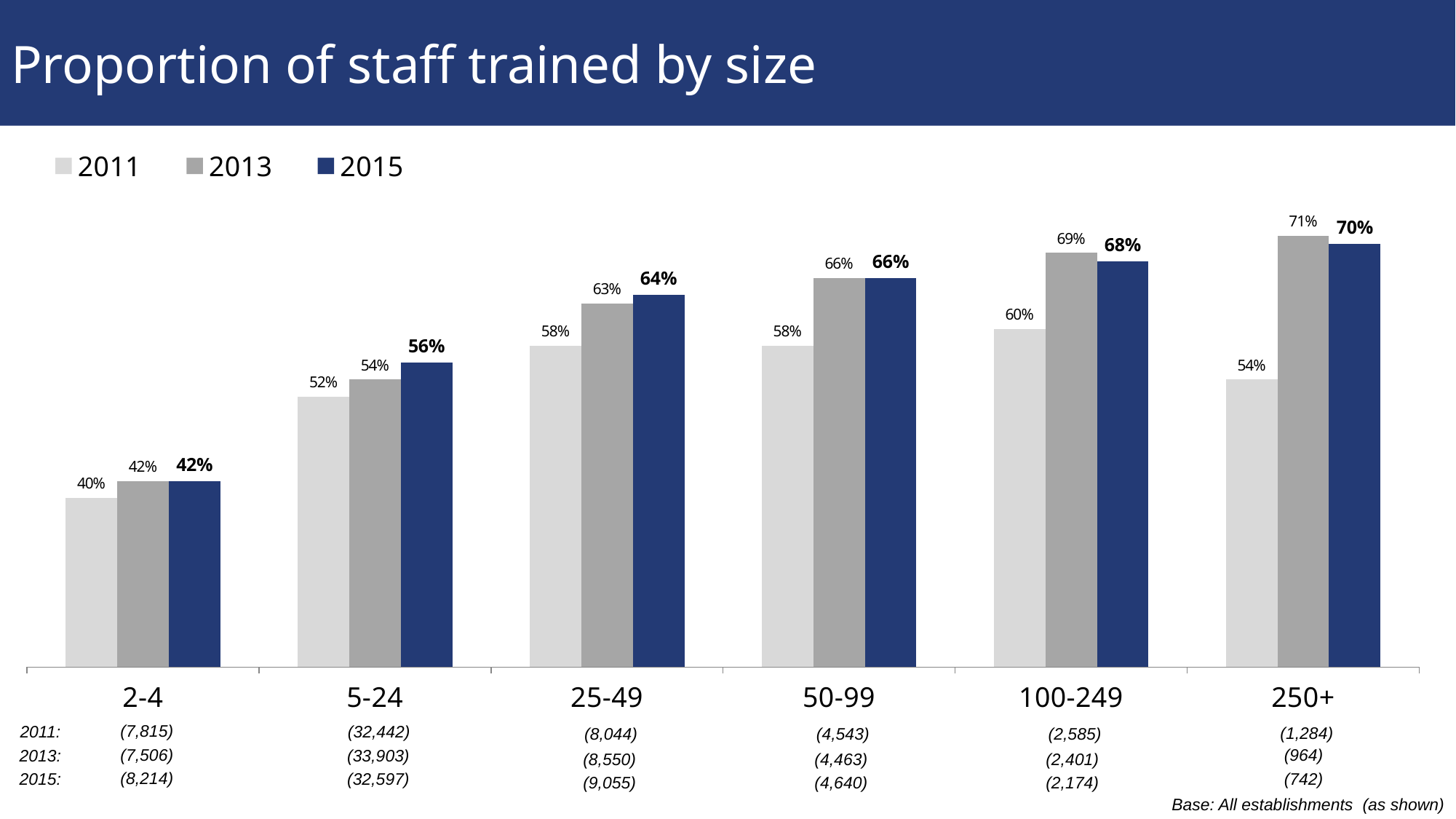
For the 250+ size band, which year has the larger value: 2013 or 2015? 2013 What is the title of the chart? Proportion of staff trained by size What is the proportion of staff trained in 2015 for establishments with 2-4 staff? 42% What is the proportion of staff trained in 2011 for establishments with 100-249 staff? 60% What is the difference between the 2015 and 2011 values for the 5-24 size band? 4 percentage points How many size bands are shown on the x axis? 6 Which size band has the highest proportion of staff trained in 2015? 250+ What kind of chart is shown on the slide? Bar chart Do the 2015 values generally rise or fall as establishment size increases from 2-4 to 250+? Rise Which size band has the lowest proportion of staff trained in 2011? 2-4 What is the proportion of staff trained in 2013 for establishments with 250+ staff? 71% How many series does the legend list? 3